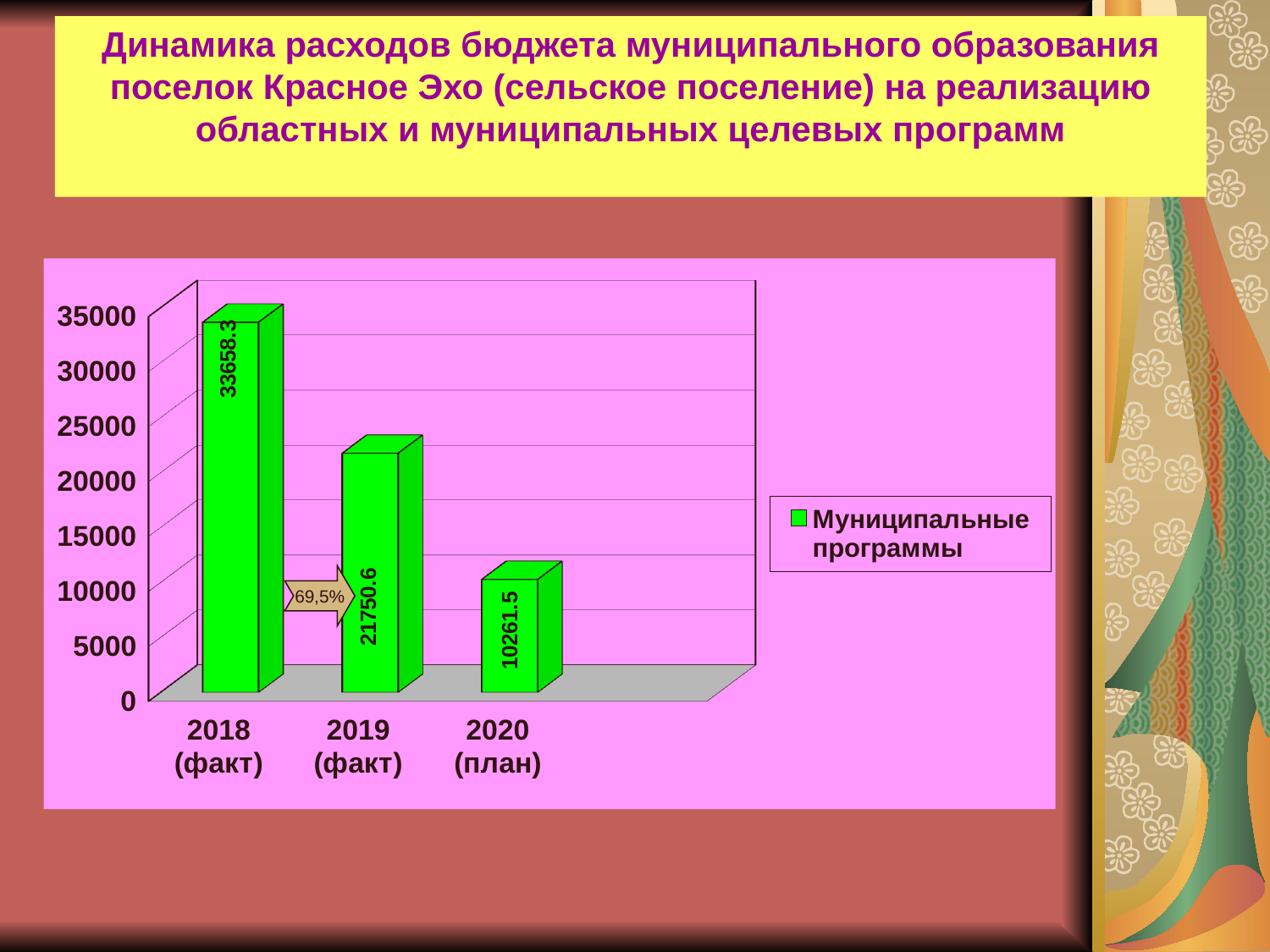
What kind of chart is shown on the slide? bar chart What is the value for 2018 (факт)? 33658.3 What is the value for 2020 (план)? 10261.5 Is the value for 2020 (план) greater or less than 15000? less Do the values rise or fall from 2018 (факт) to 2020 (план)? fall Which category has the lowest value? 2020 (план) What is the value for 2019 (факт)? 21750.6 What is the difference between the values for 2019 (факт) and 2020 (план)? 11489.1 Which is larger, the value for 2019 (факт) or the value for 2020 (план)? 2019 (факт) Which category has the highest value? 2018 (факт) What is the difference between the values for 2018 (факт) and 2019 (факт)? 11907.7 How many categories are shown on the x axis? 3